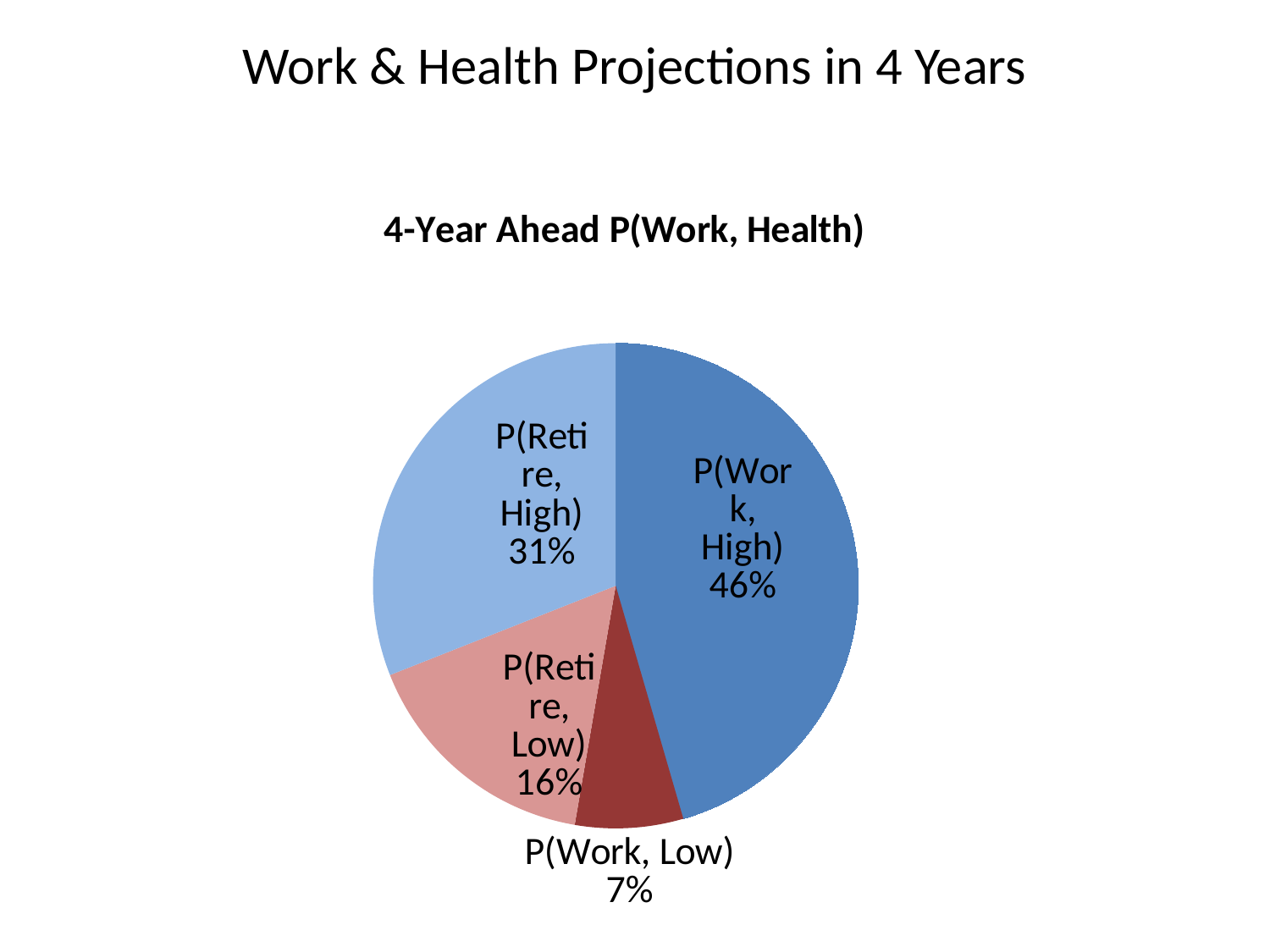
Which slice of the pie is the largest? P(Work, High) What is the difference in percentage points between P(Retire, Low) and P(Work, Low)? 9 What share of the pie does P(Retire, Low) represent? 16% Which is larger, P(Retire, High) or P(Retire, Low)? P(Retire, High) What share of the pie does P(Work, High) represent? 46% How many slices does the pie chart have? 4 What is the title of the chart? 4-Year Ahead P(Work, Health) What share of the pie does P(Work, Low) represent? 7% Which slice of the pie is the smallest? P(Work, Low) What kind of chart is shown on the slide? Pie chart What is the difference in percentage points between P(Work, High) and P(Retire, High)? 15